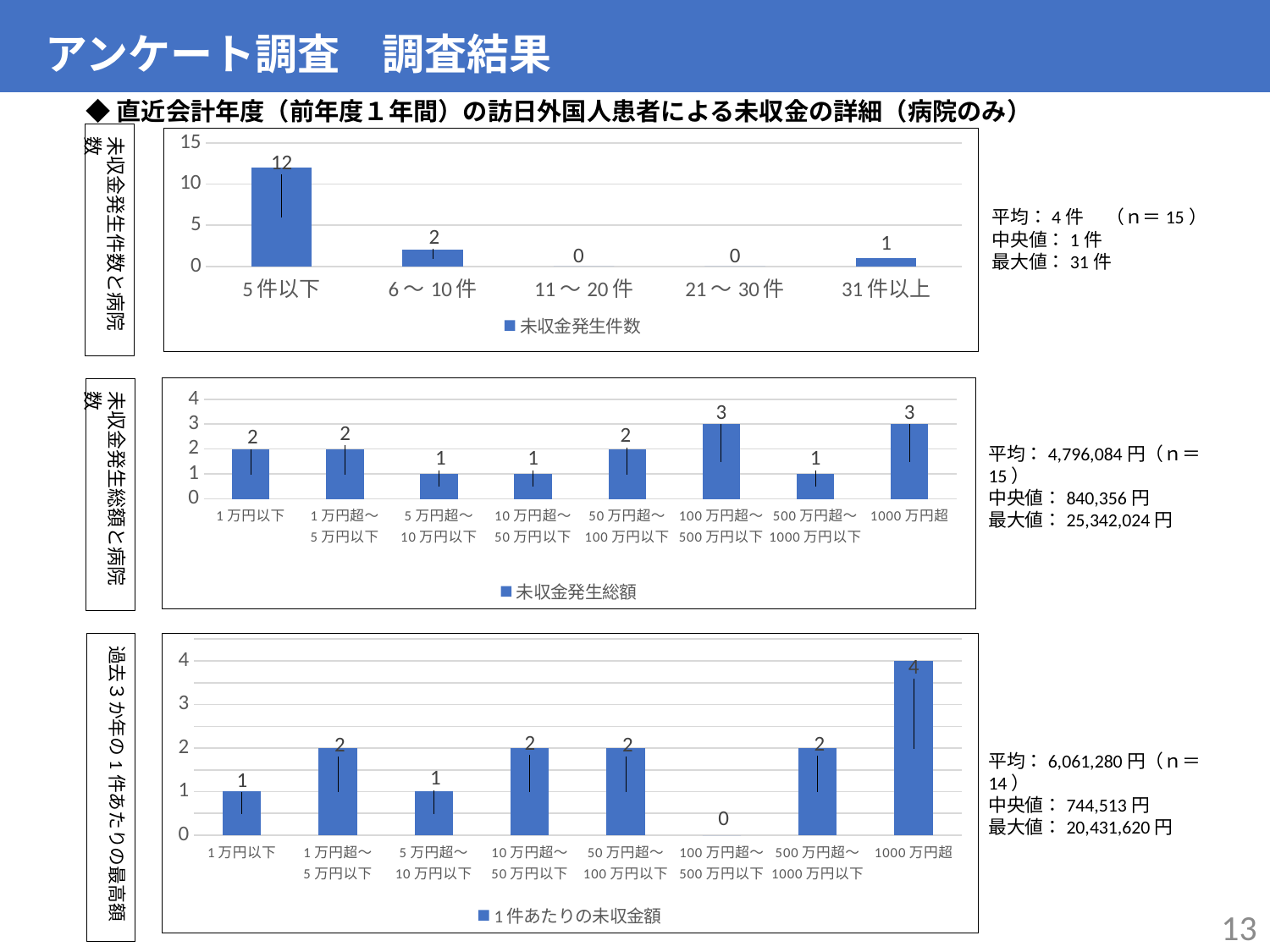
In the middle chart (未収金発生総額と病院数), what is the value for 100万円超～500万円以下? 3 What type of chart is the bottom chart (過去3か年の1件あたりの最高額)? Bar chart In the bottom chart (過去3か年の1件あたりの最高額), which category has the highest value? 1000万円超 In the top chart (未収金発生件数と病院数), which category has the highest value? 5件以下 In the top chart (未収金発生件数と病院数), what is the value for 31件以上? 1 In the top chart (未収金発生件数と病院数), how many categories are shown on the x axis? 5 In the middle chart (未収金発生総額と病院数), how many categories are shown on the x axis? 8 In the top chart (未収金発生件数と病院数), what is the difference between the values for 5件以下 and 6～10件? 10 In the bottom chart (過去3か年の1件あたりの最高額), what is the value for 100万円超～500万円以下? 0 In the top chart (未収金発生件数と病院数), what is the value for 5件以下? 12 In the bottom chart (過去3か年の1件あたりの最高額), what is the difference between the values for 1000万円超 and 1万円以下? 3 In the middle chart (未収金発生総額と病院数), which is larger, the value for 1万円以下 or the value for 5万円超～10万円以下? 1万円以下